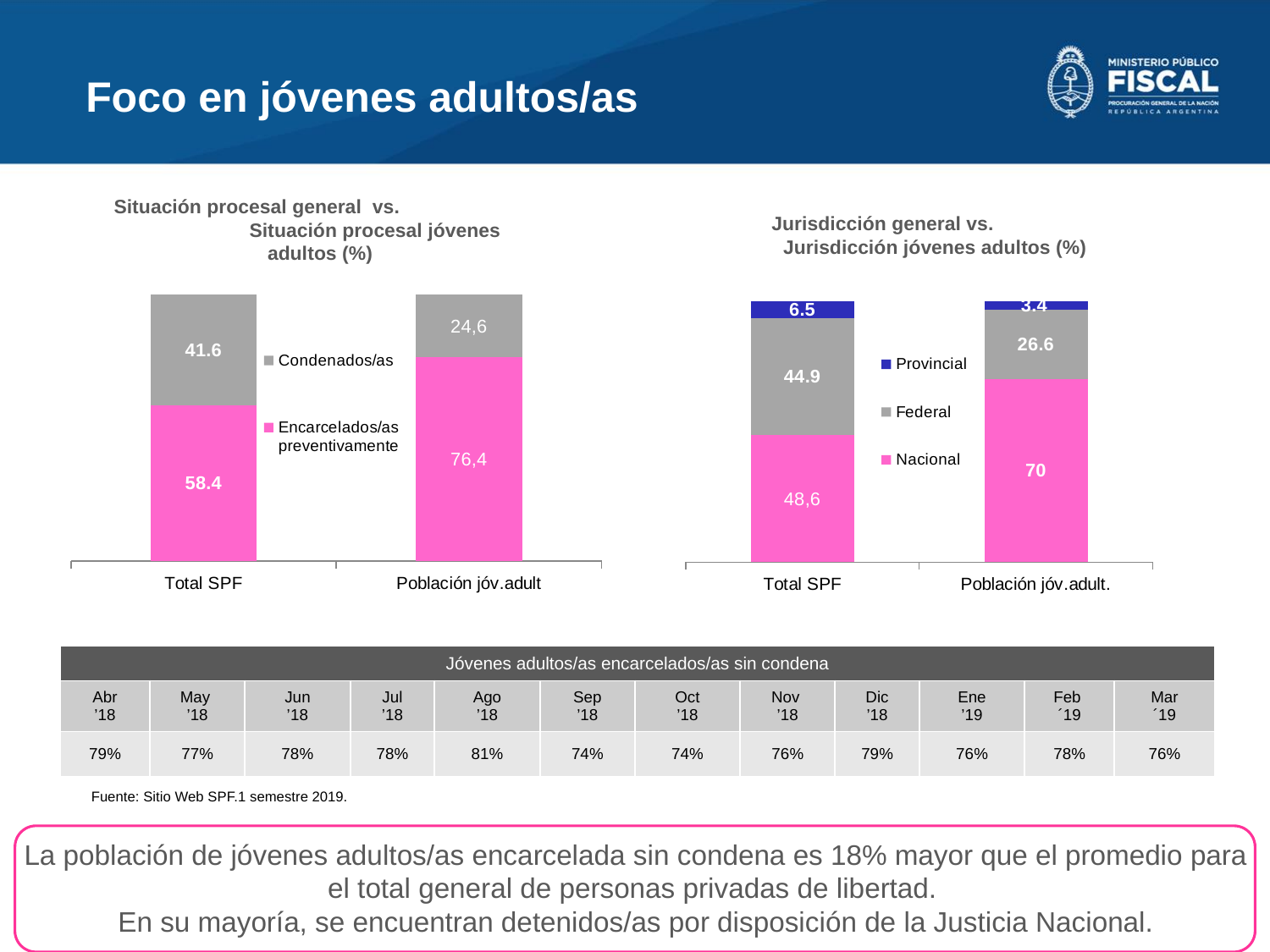
What kind of chart is the right chart (Jurisdicción general vs. Jurisdicción jóvenes adultos)? Stacked bar chart In the left chart (Situación procesal general vs. Situación procesal jóvenes adultos), how many series does the legend list? 2 In the left chart (Situación procesal general vs. Situación procesal jóvenes adultos), what is the value for Condenados/as for Población jóv.adult? 24,6 In the right chart (Jurisdicción general vs. Jurisdicción jóvenes adultos), which is larger: the Federal value for Total SPF or the Federal value for Población jóv.adult.? Total SPF In the right chart (Jurisdicción general vs. Jurisdicción jóvenes adultos), what is the value for Provincial for Total SPF? 6.5 In the left chart (Situación procesal general vs. Situación procesal jóvenes adultos), what is the difference between the Encarcelados/as preventivamente values for Población jóv.adult and Total SPF? 18 In the left chart (Situación procesal general vs. Situación procesal jóvenes adultos), what is the value for Encarcelados/as preventivamente for Población jóv.adult? 76,4 In the right chart (Jurisdicción general vs. Jurisdicción jóvenes adultos), which series has the smallest value for Población jóv.adult.? Provincial In the right chart (Jurisdicción general vs. Jurisdicción jóvenes adultos), what is the value for Nacional for Población jóv.adult.? 70 In the right chart (Jurisdicción general vs. Jurisdicción jóvenes adultos), what is the total of the stacked bar for Total SPF? 100 In the left chart (Situación procesal general vs. Situación procesal jóvenes adultos), what is the value for Encarcelados/as preventivamente for Total SPF? 58.4 In the right chart (Jurisdicción general vs. Jurisdicción jóvenes adultos), what is the value for Federal for Total SPF? 44.9